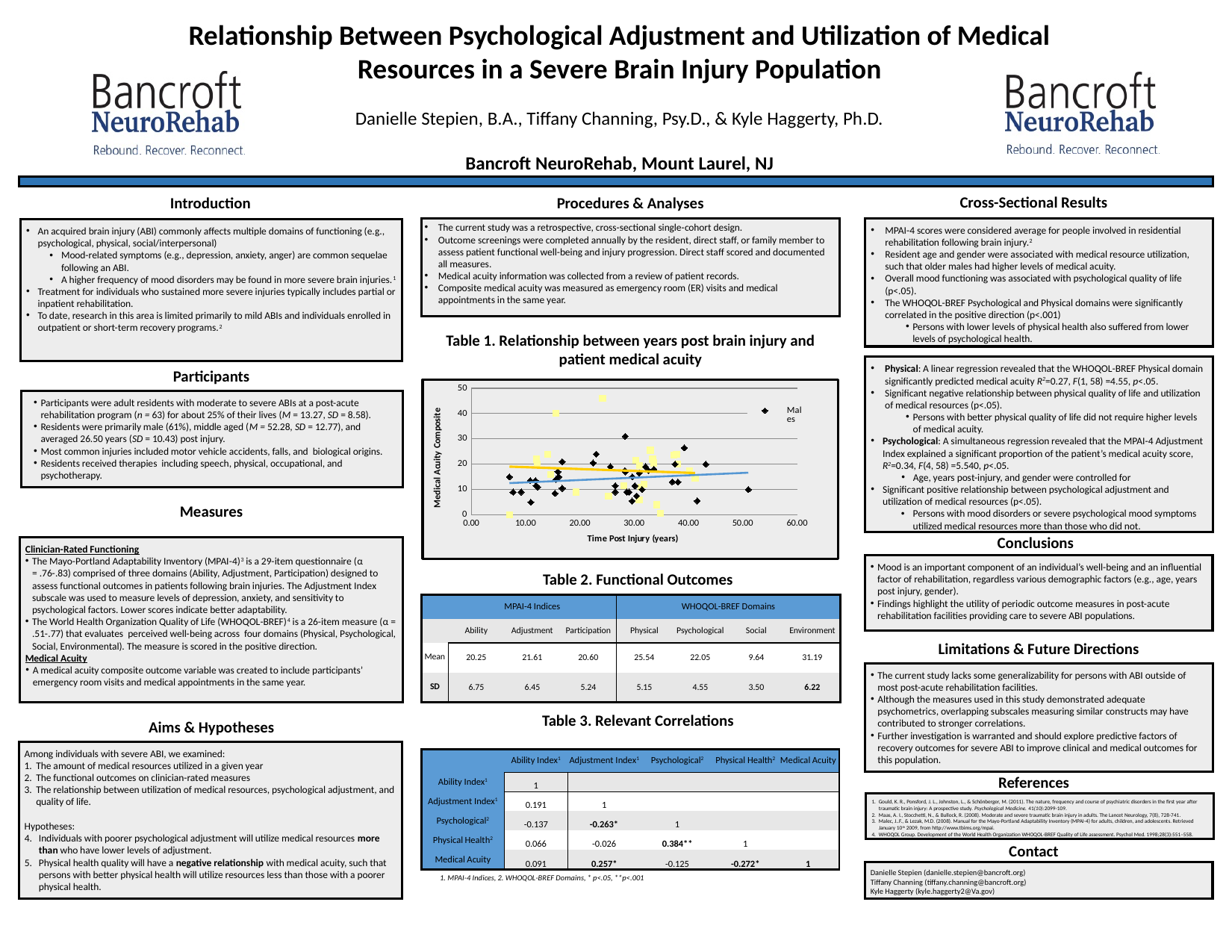
In the Table 1 scatter plot, is the highest plotted Medical Acuity Composite value greater or less than 40? greater In the Table 1 scatter plot, is the highest plotted Medical Acuity Composite value greater or less than 50? less In the Table 1 scatter plot, which series is plotted with black diamond markers according to the legend? Males What kind of chart is shown under 'Table 1. Relationship between years post brain injury and patient medical acuity'? scatter plot In the Table 1 scatter plot, does the orange trend line rise or fall as Time Post Injury increases? fall In the Table 1 scatter plot, what is the title of the vertical axis? Medical Acuity Composite In the Table 1 scatter plot, does the blue trend line rise or fall as Time Post Injury increases? rise